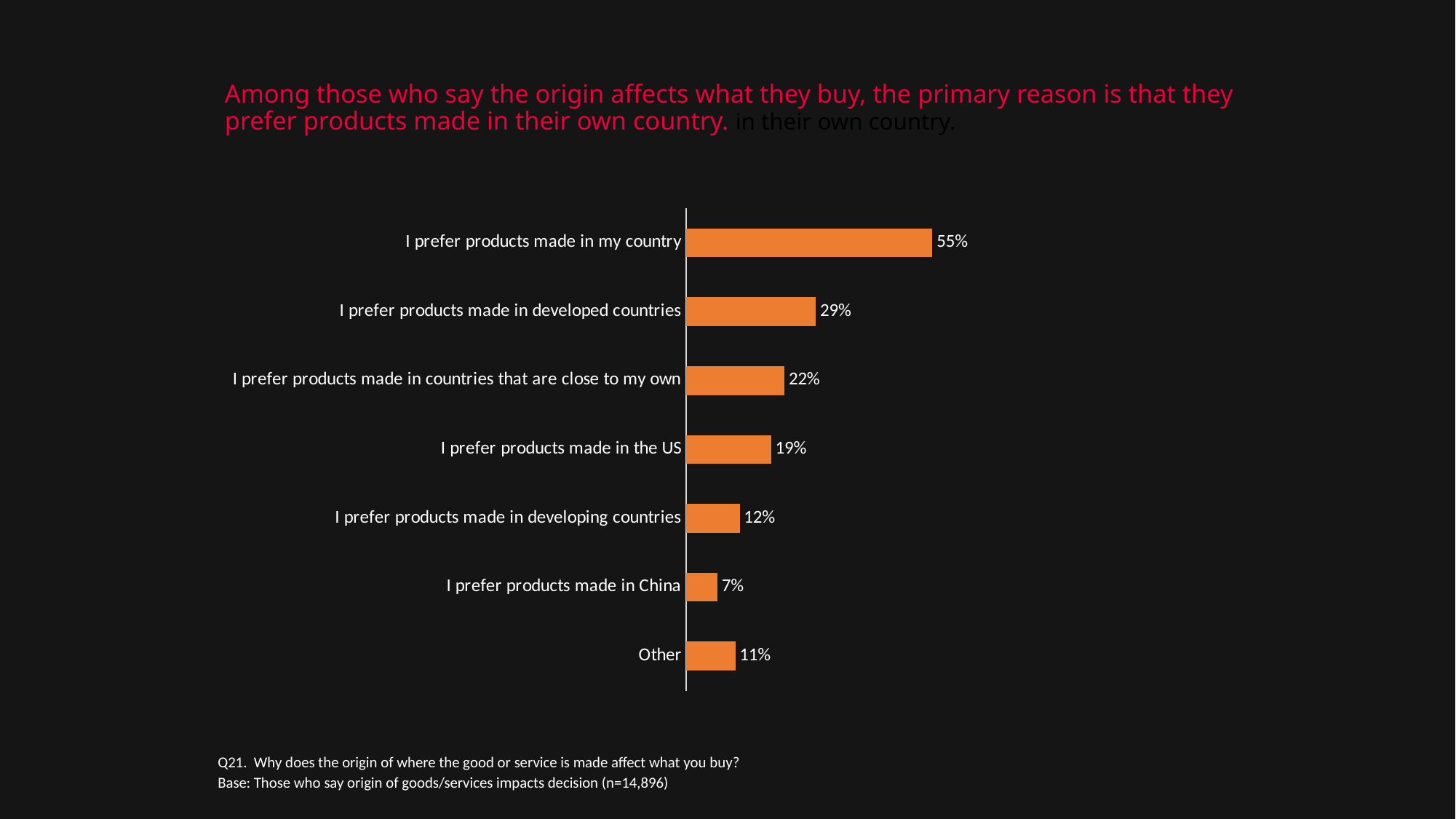
Which reason has the lowest percentage? I prefer products made in China How many categories are shown in the chart? 7 What kind of chart is shown on the slide? Bar chart Which is larger: 'I prefer products made in developing countries' or 'Other'? I prefer products made in developing countries What percentage of respondents say they prefer products made in their own country? 55% What colour are the bars in the chart? Orange What is the value for 'I prefer products made in China'? 7% What percentage say they prefer products made in the US? 19% What is the difference between 'I prefer products made in countries that are close to my own' and 'I prefer products made in the US'? 3 percentage points What is the value for 'I prefer products made in developed countries'? 29% What is the difference between 'I prefer products made in my country' and 'I prefer products made in developed countries'? 26 percentage points Which reason has the highest percentage? I prefer products made in my country